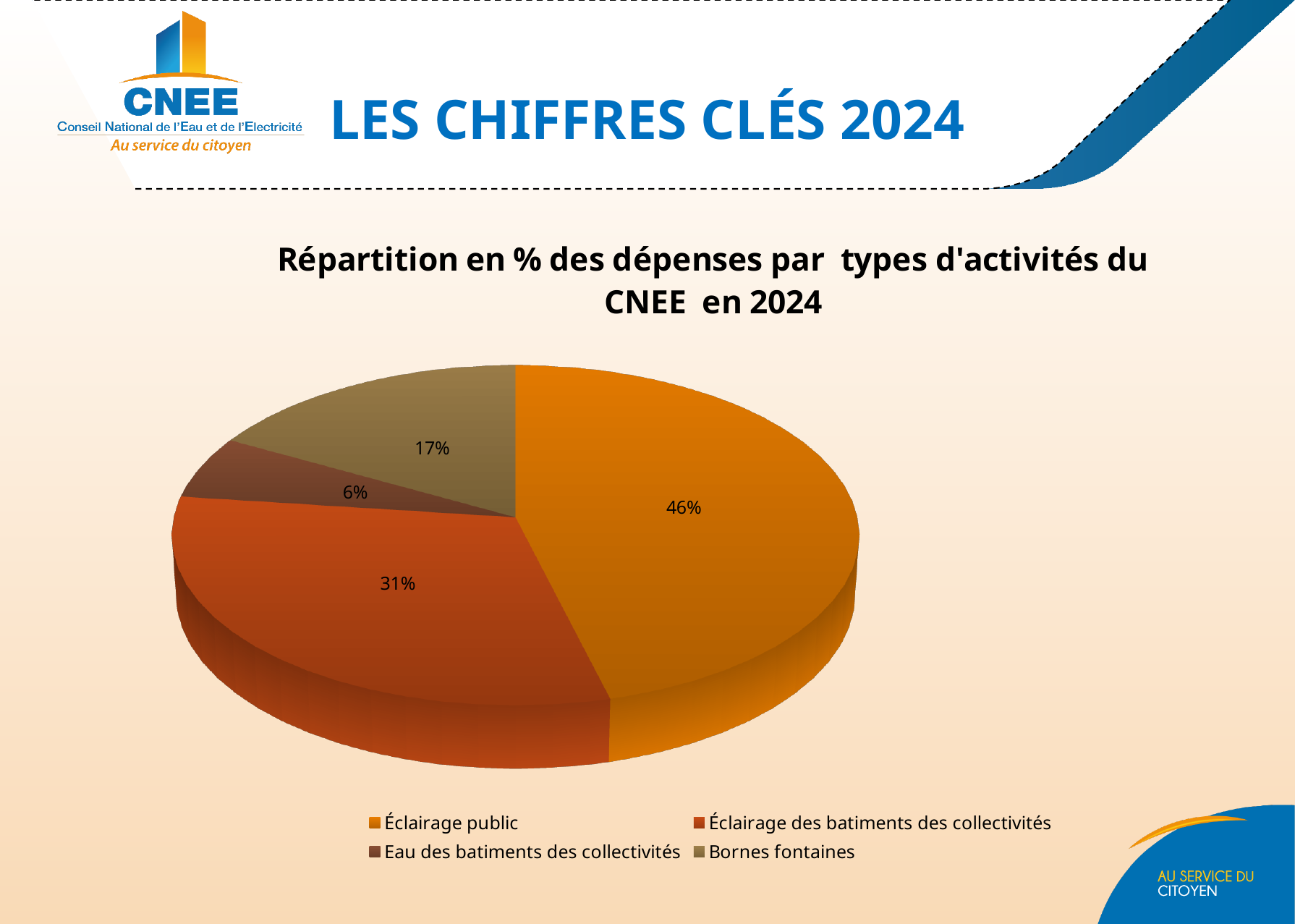
Which activity type has the largest share of expenses? Éclairage public What kind of chart is shown on the slide? Pie chart What is the combined share of Éclairage public and Bornes fontaines? 63% Which activity type has the smallest share of expenses? Eau des batiments des collectivités What share of expenses does Éclairage public represent? 46% Which is larger: the share for Bornes fontaines or the share for Eau des batiments des collectivités? Bornes fontaines What share of expenses does Bornes fontaines represent? 17% What is the difference in percentage points between Éclairage public and Éclairage des batiments des collectivités? 15 What is the title of the chart? Répartition en % des dépenses par types d'activités du CNEE en 2024 What share of expenses does Éclairage des batiments des collectivités represent? 31% What share of expenses does Eau des batiments des collectivités represent? 6% How many activity types are shown in the pie chart? 4